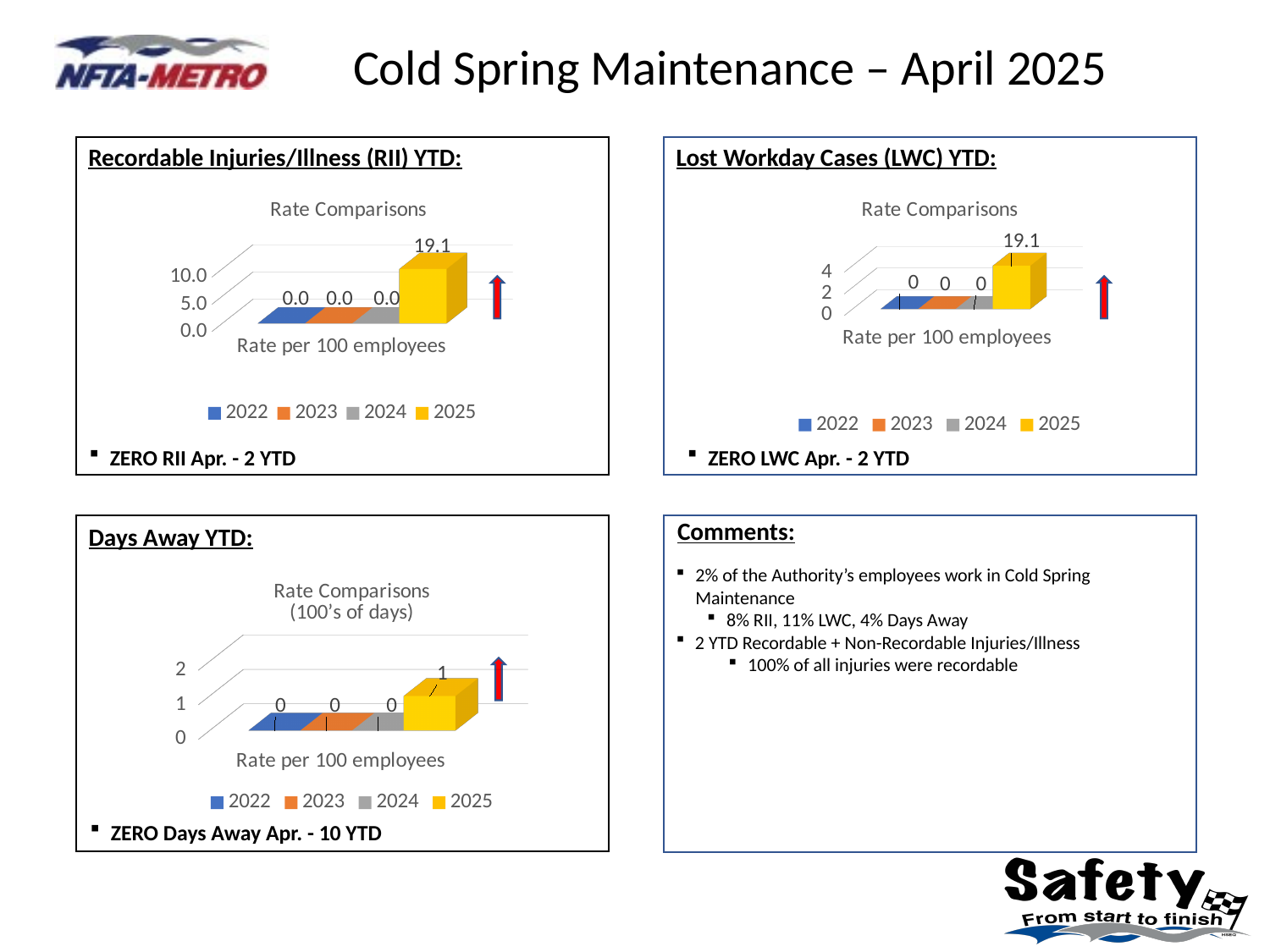
In the Lost Workday Cases (LWC) YTD chart, which is larger, the value for 2025 or the value for 2023? 2025 In the Days Away YTD chart, what is the value for 2025? 1 In the Recordable Injuries/Illness (RII) YTD chart, what is the value for 2025? 19.1 How many series does the legend list in the Days Away YTD chart? 4 In the Days Away YTD chart, what is the value for 2024? 0 In the Recordable Injuries/Illness (RII) YTD chart, what is the value for 2023? 0.0 What is the x-axis category label in the Recordable Injuries/Illness (RII) YTD chart? Rate per 100 employees What kind of chart is the Lost Workday Cases (LWC) YTD chart? Bar chart In the Lost Workday Cases (LWC) YTD chart, what is the value for 2022? 0 In the Days Away YTD chart, what is the difference between the 2025 value and the 2024 value? 1 In the Lost Workday Cases (LWC) YTD chart, what is the value for 2025? 19.1 In the Recordable Injuries/Illness (RII) YTD chart, which year has the highest value? 2025